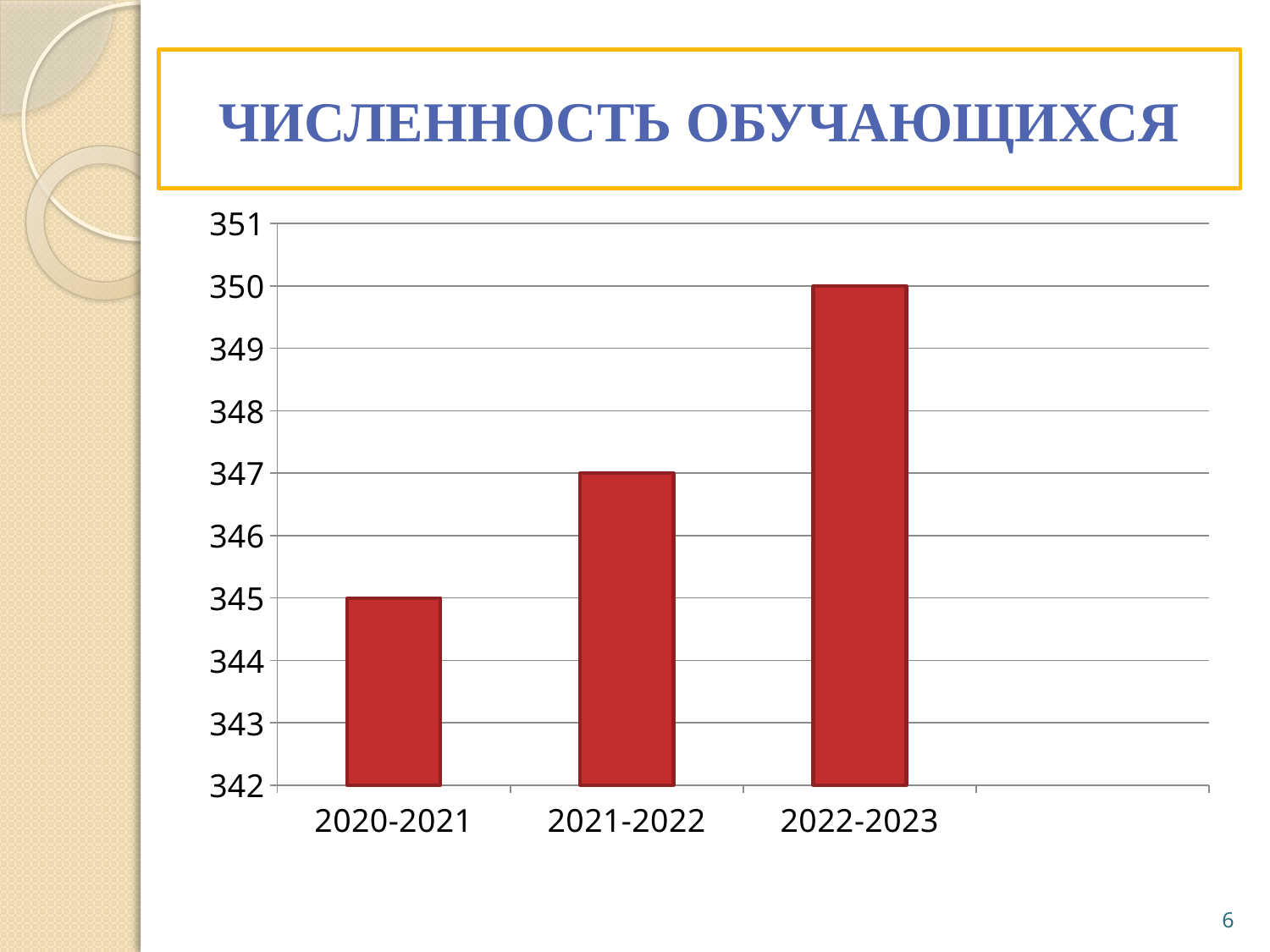
What is the difference between the values for 2021-2022 and 2020-2021? 2 Which is larger, the value for 2021-2022 or the value for 2022-2023? 2022-2023 What is the value for 2020-2021? 345 Do the values rise or fall from 2020-2021 to 2022-2023? rise Is the value for 2022-2023 greater or less than 348? greater What is the value for 2021-2022? 347 What is the difference between the values for 2022-2023 and 2020-2021? 5 What is the value for 2022-2023? 350 What kind of chart is shown on the slide? bar chart Which year has the highest value? 2022-2023 How many categories are shown on the x axis? 3 Which year has the lowest value? 2020-2021